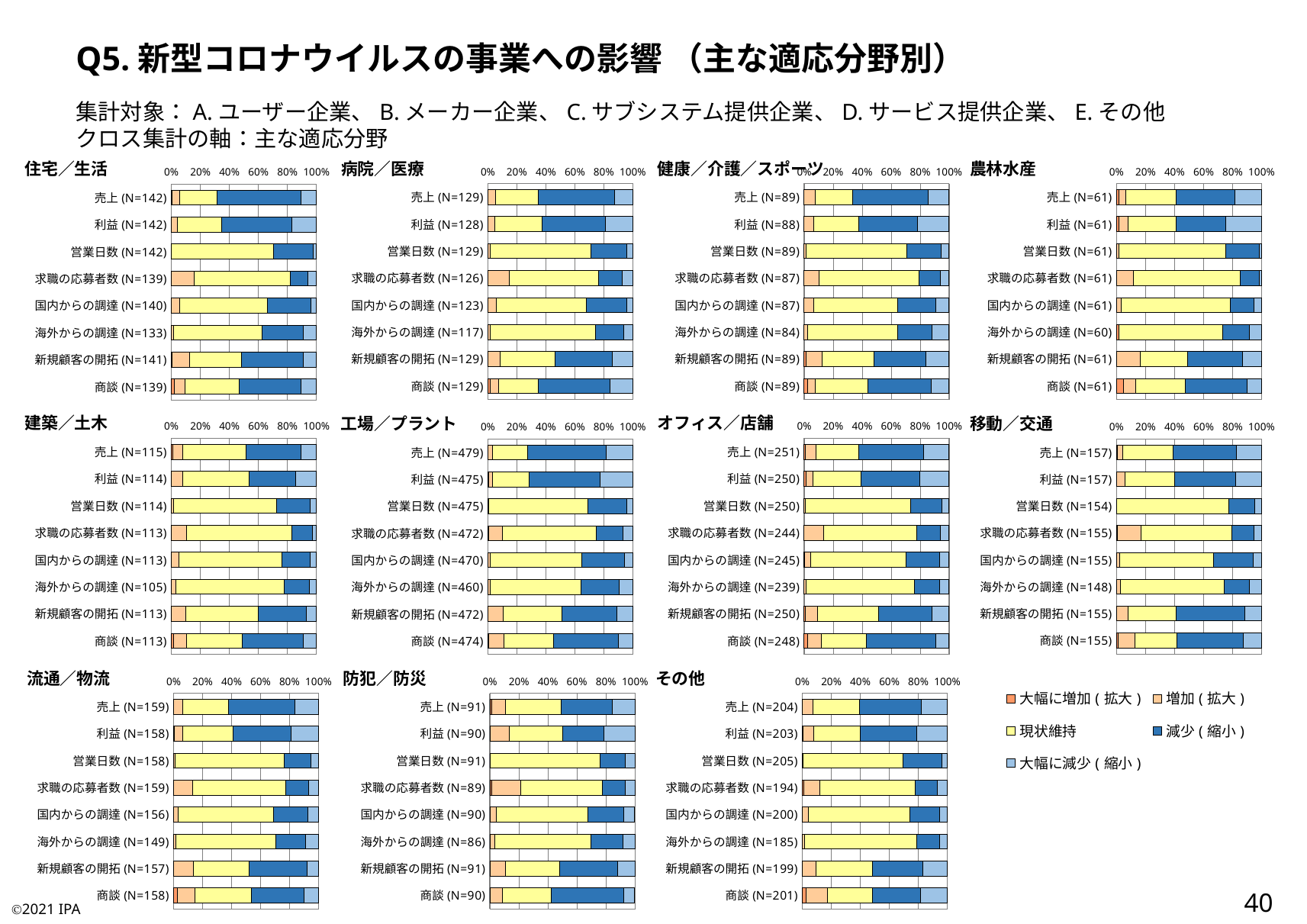
How many charts are shown on the slide? 11 In the 工場／プラント chart, for 売上 (N=479), which segment is larger: 現状維持 or 減少（縮小）? 減少（縮小） What kind of chart is the 住宅／生活 chart? bar chart What is the first entry in the legend? 大幅に増加（拡大） How many series does the legend list? 5 In the 工場／プラント chart, is the 現状維持 share for 売上 (N=479) greater or less than 40%? less In the 住宅／生活 chart, is the 現状維持 share for 営業日数 (N=142) greater or less than 60%? greater In the 農林水産 chart, is the 現状維持 share for 営業日数 (N=61) greater or less than 60%? greater How many categories are plotted in the 病院／医療 chart? 8 What is the title of the slide? Q5. 新型コロナウイルスの事業への影響（主な適応分野別）